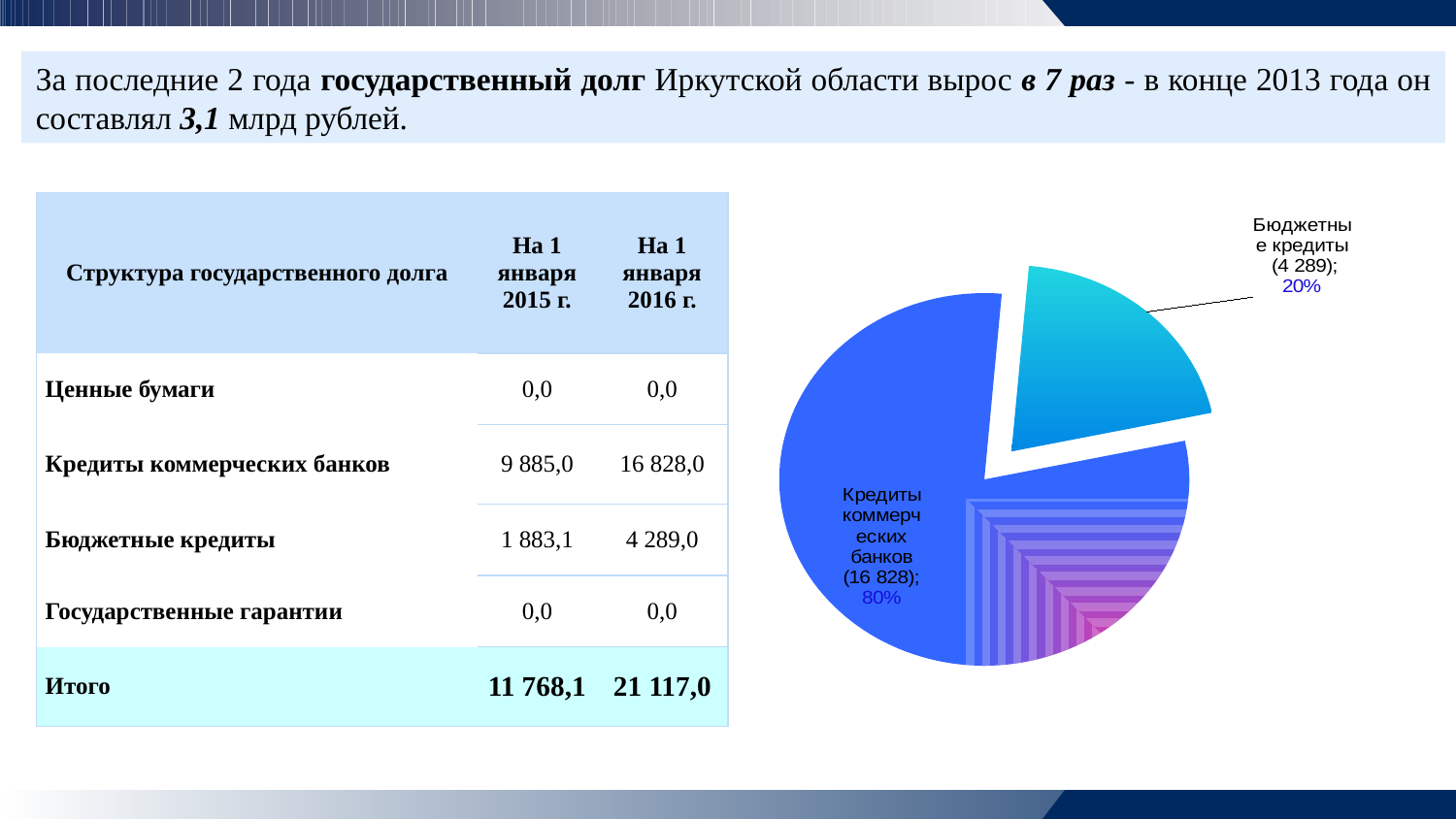
What share of the pie does Кредиты коммерческих банков represent? 80% What is the difference in percentage points between the Кредиты коммерческих банков slice and the Бюджетные кредиты slice? 60 percentage points Which is larger in the pie chart: Кредиты коммерческих банков or Бюджетные кредиты? Кредиты коммерческих банков Which slice of the pie chart is the smallest? Бюджетные кредиты What kind of chart is shown on the slide? pie chart Which slice of the pie chart is pulled out (exploded) from the rest of the pie? Бюджетные кредиты What share of the pie does Бюджетные кредиты represent? 20% What value is labelled for Бюджетные кредиты in the pie chart? 4 289 Which slice of the pie chart is the largest? Кредиты коммерческих банков Is the share of the Бюджетные кредиты slice greater or less than 50%? less What value is labelled for Кредиты коммерческих банков in the pie chart? 16 828 How many slices does the pie chart have? 2